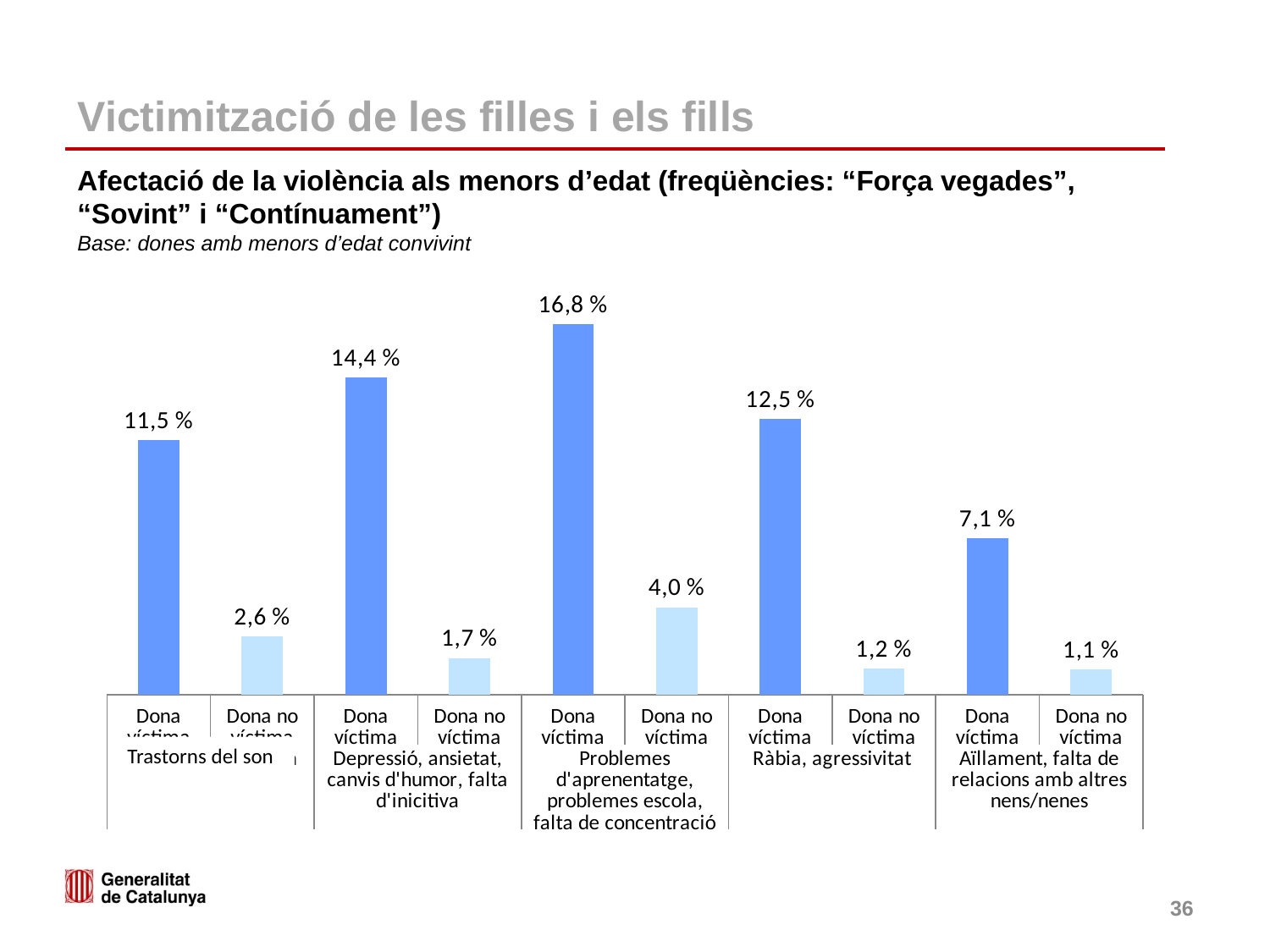
What is the difference between the "Dona víctima" and "Dona no víctima" values in the "Depressió, ansietat, canvis d'humor, falta d'inicitiva" group? 12,7 % What is the value for "Dona víctima" in the "Ràbia, agressivitat" group? 12,5 % How many groups of categories does the chart show? 5 Which group has the highest "Dona víctima" value? Problemes d'aprenentatge, problemes escola, falta de concentració What is the value for "Dona no víctima" in the "Aïllament, falta de relacions amb altres nens/nenes" group? 1,1 % How many bars are plotted in the chart? 10 Which group has the lowest "Dona no víctima" value? Aïllament, falta de relacions amb altres nens/nenes What is the value for "Dona no víctima" in the "Problemes d'aprenentatge, problemes escola, falta de concentració" group? 4,0 % What kind of chart is shown on the slide? Bar chart Which is larger: the "Dona víctima" value for "Trastorns del son" or for "Ràbia, agressivitat"? Ràbia, agressivitat What is the value for "Dona víctima" in the "Trastorns del son" group? 11,5 % What is the base stated below the chart heading? Dones amb menors d'edat convivint